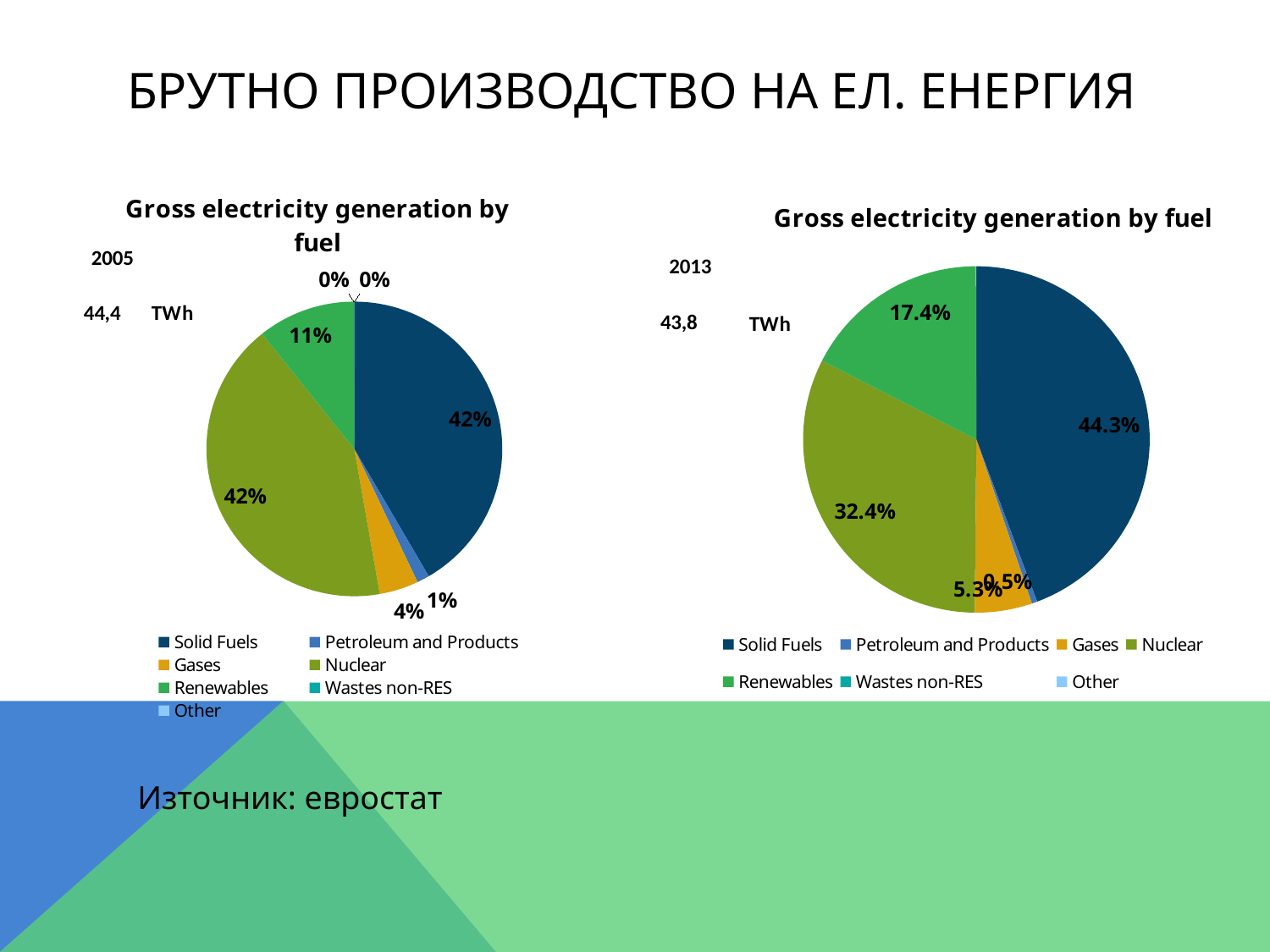
In the right chart (2013), what share does Renewables have? 17.4% In the right chart (2013), what share of gross electricity generation comes from Solid Fuels? 44.3% In the right chart (2013), which is larger, the share of Gases or the share of Renewables? Renewables In the left chart (2005), what share does Renewables have? 11% In the right chart (2013), what is the difference between the Solid Fuels share and the Nuclear share? 11.9% How many entries does the legend of the right chart (2013) list? 7 What is the title of the left chart? Gross electricity generation by fuel In the left chart (2005), what share does Gases have? 4% In the left chart (2005), which is larger, the share of Renewables or the share of Gases? Renewables In the right chart (2013), what share does Nuclear have? 32.4% In the right chart (2013), which fuel has the largest share? Solid Fuels What kind of chart is the left chart (2005)? pie chart